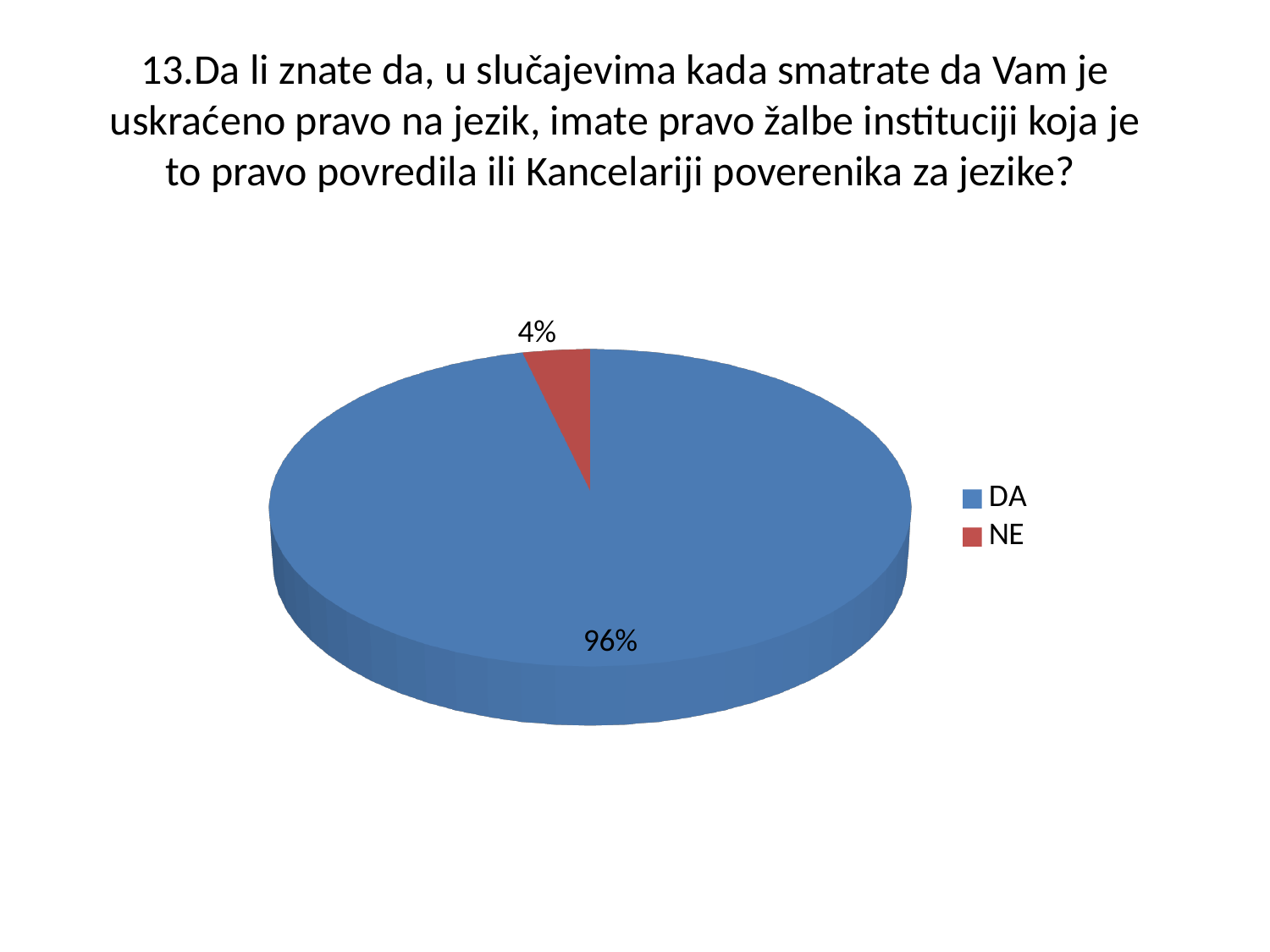
What share of the pie does NE represent? 4% How many categories does the pie chart have? 2 What is the difference in percentage points between the DA and NE slices? 92 What colour is the DA slice? Blue How many entries does the legend list? 2 What colour is the NE slice? Red What kind of chart is shown on the slide? Pie chart What share of the pie does DA represent? 96% Which category has the largest slice of the pie? DA Which slice is larger, DA or NE? DA Which category has the smallest slice of the pie? NE